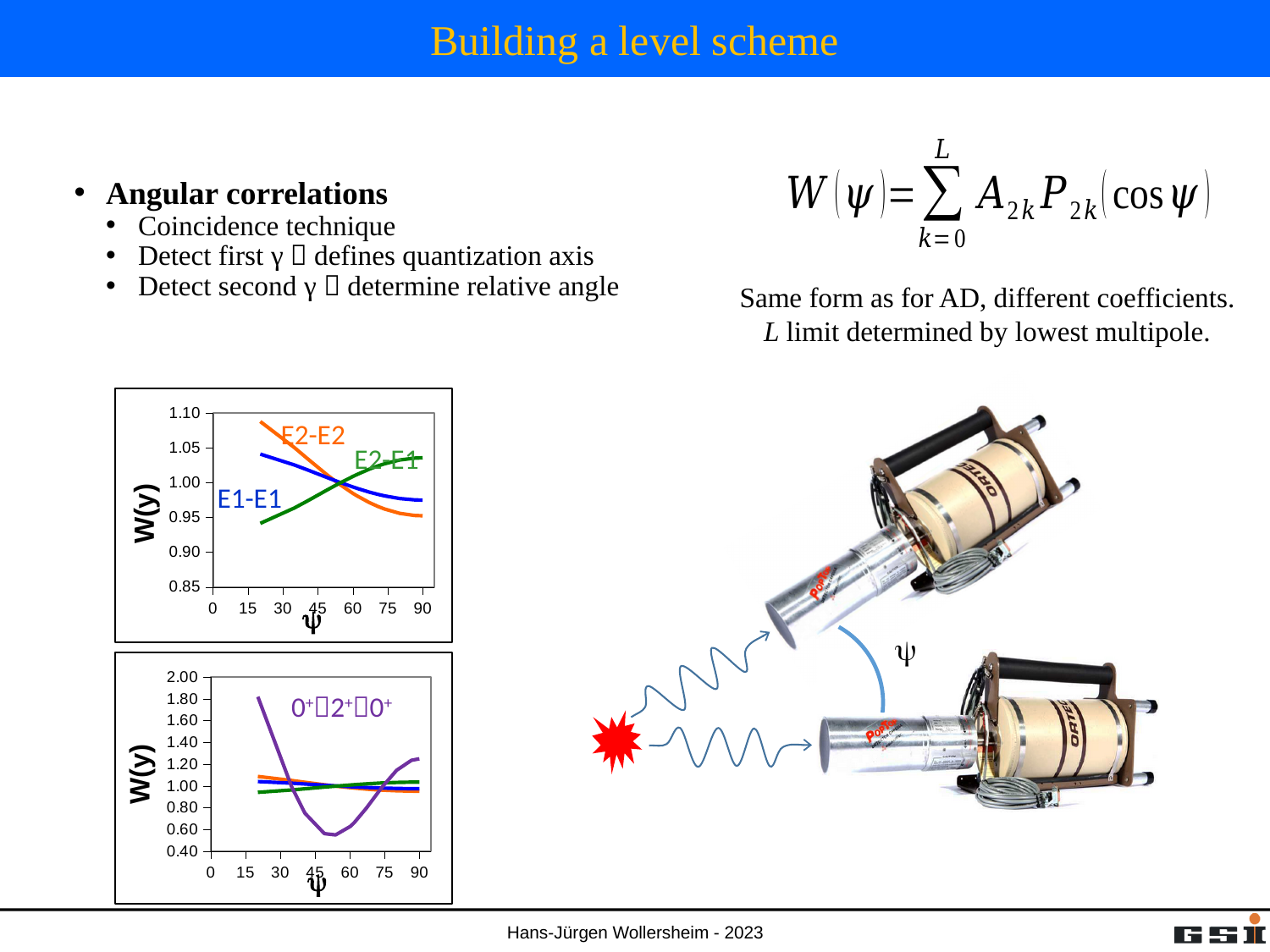
In the top chart, is the value of the E2-E2 curve at ψ = 20 greater or less than 1.05? greater In the top chart, at ψ = 90, is the E1-E1 curve higher or lower than the E2-E2 curve? higher In the top chart, does the E2-E1 curve rise or fall as ψ increases from 20 to 90? rise In the top chart, is the value of the E2-E1 curve at ψ = 20 greater or less than 1.00? less What is the y-axis label of the top chart? W(y) In the top chart, which curve has the highest value at ψ = 20? E2-E2 In the bottom chart, is the minimum value of the purple 0+→2+→0+ curve greater or less than 0.80? less In the top chart, how many curves are plotted? 3 What kind of chart is the top chart on the slide? line chart In the top chart, does the E2-E2 curve rise or fall as ψ increases from 20 to 90? fall In the top chart, which curve has the lowest value at ψ = 20? E2-E1